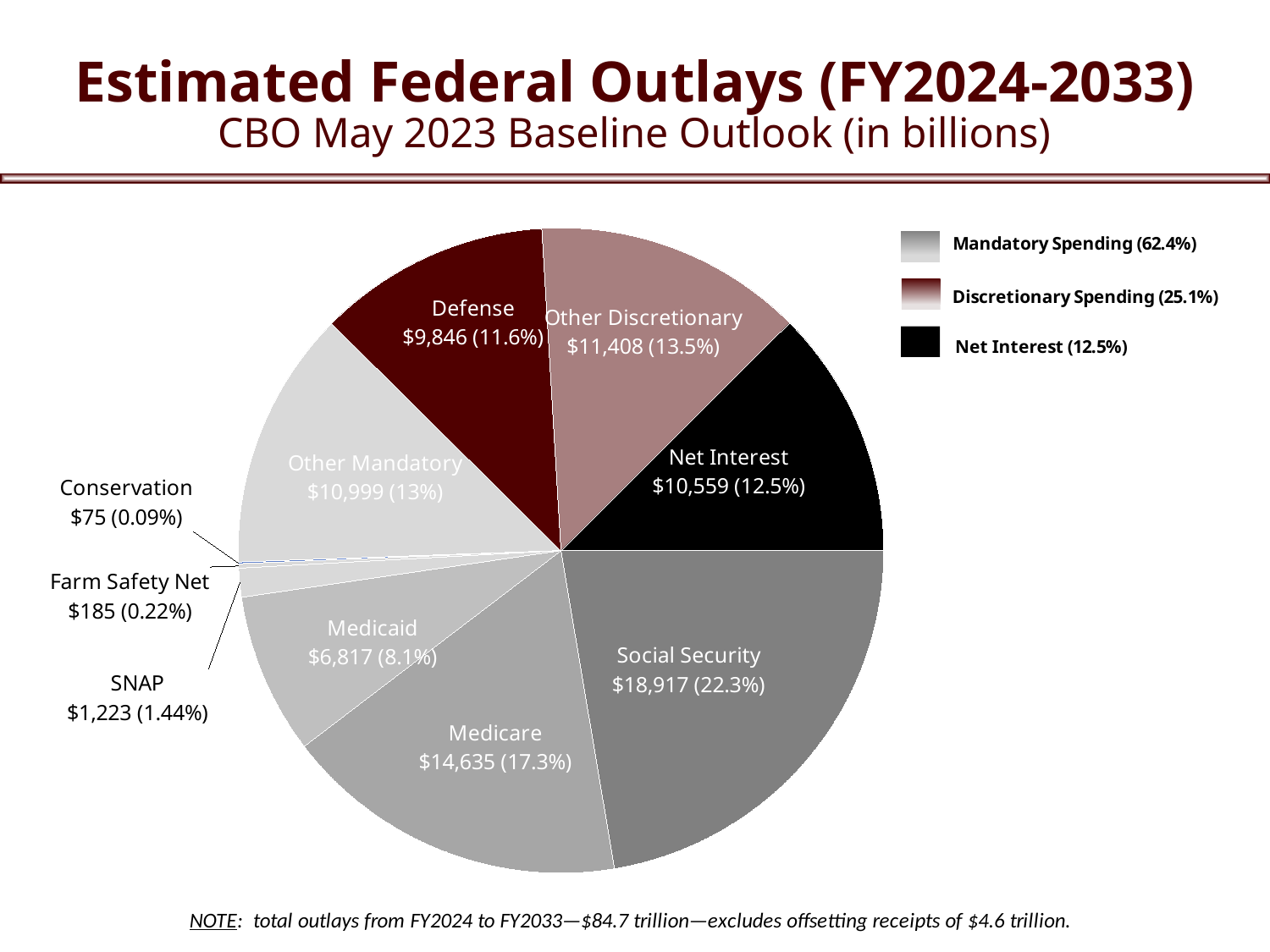
Which slice of the pie is the largest? Social Security What is the value shown for Social Security? $18,917 (22.3%) What percentage does the legend give for Mandatory Spending? 62.4% What is the value shown for Net Interest? $10,559 (12.5%) Which slice of the pie is the smallest? Conservation How many slices does the pie chart have? 10 What is the difference in billions between Social Security and Medicare? $4,282 What kind of chart is shown on the slide? Pie chart How many categories does the legend list? 3 Which is larger, Other Discretionary or Other Mandatory? Other Discretionary What share of the pie does Medicare represent? 17.3% What is the value shown for Defense? $9,846 (11.6%)